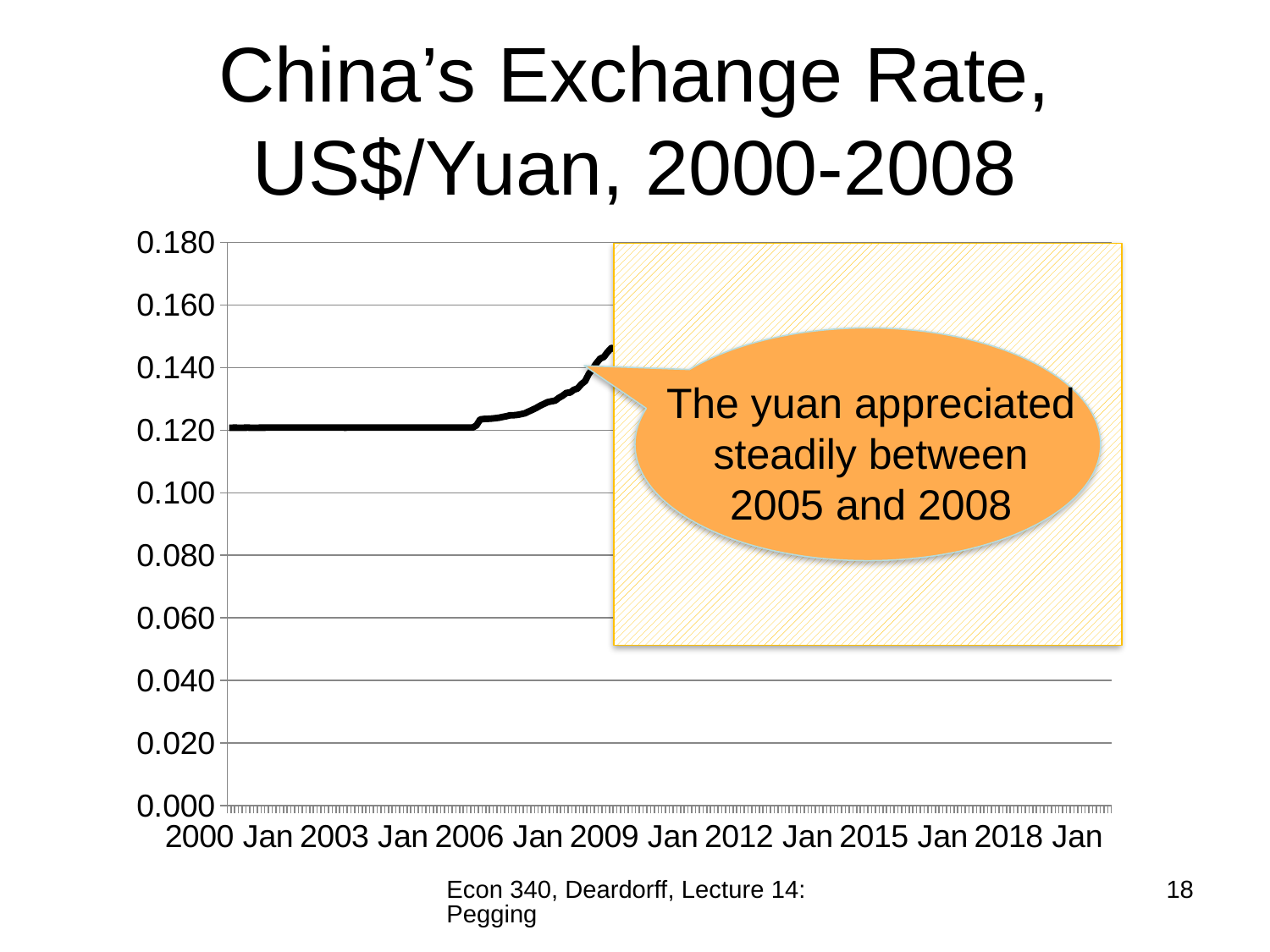
Is the exchange rate at 2008 higher or lower than at 2000 Jan? higher What does the callout on the chart say? The yuan appreciated steadily between 2005 and 2008 Does the exchange rate rise, fall, or stay flat between 2000 Jan and 2005? stay flat Is the exchange rate value at 2003 Jan greater or less than 0.160? less Is the exchange rate value at the end of the plotted line (2008) greater or less than 0.160? less How many lines are plotted on the chart? 1 Is the exchange rate value at 2003 Jan greater or less than 0.140? less What is the title of the chart on the slide? China's Exchange Rate, US$/Yuan, 2000-2008 Does the exchange rate rise or fall between 2005 and 2008? rise What kind of chart is shown on the slide? line chart